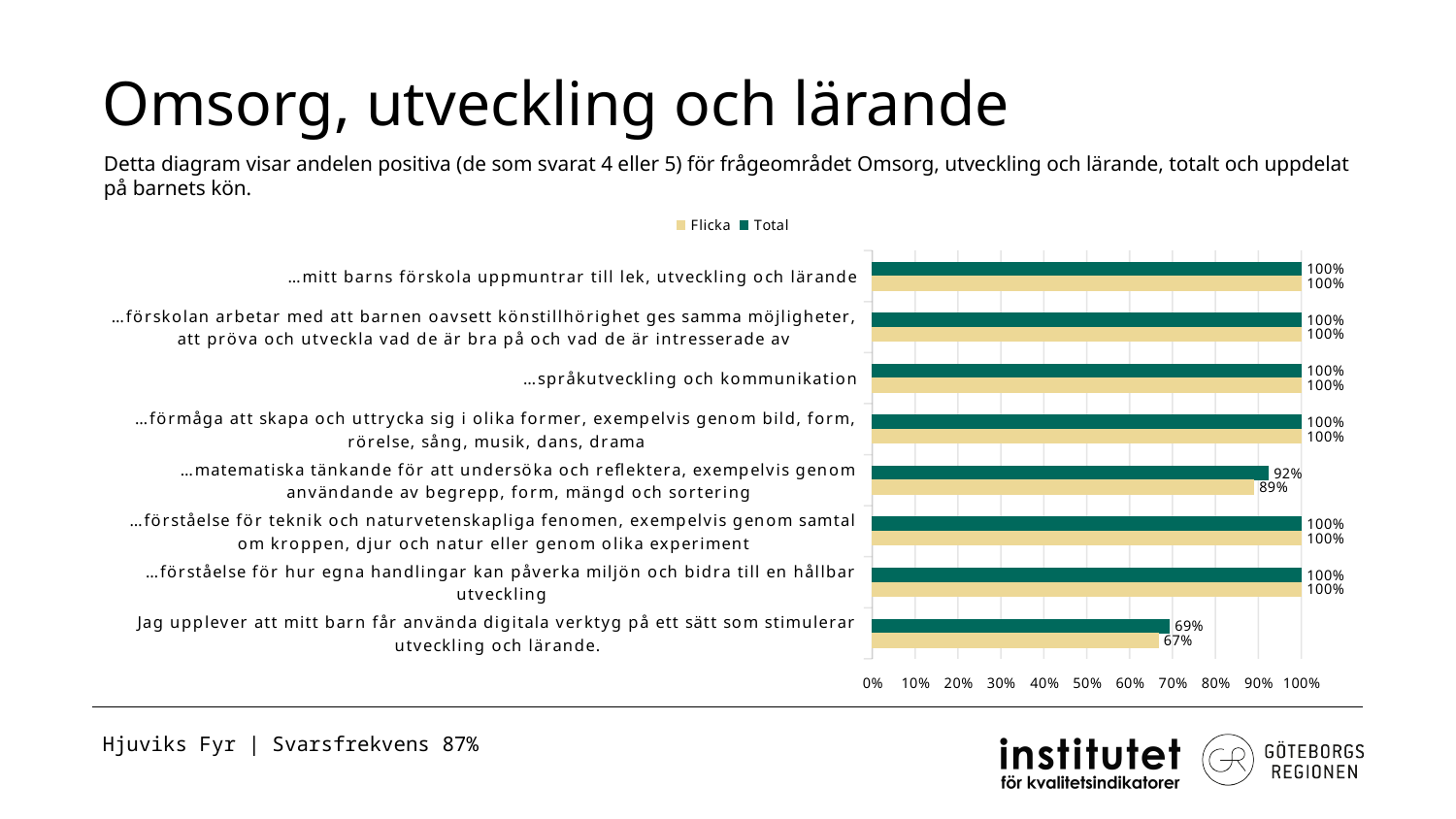
What type of chart is shown on the slide? bar chart What is the Flicka value for "…matematiska tänkande för att undersöka och reflektera, exempelvis genom användande av begrepp, form, mängd och sortering"? 89% What is the Total value for "…matematiska tänkande för att undersöka och reflektera, exempelvis genom användande av begrepp, form, mängd och sortering"? 92% How many categories (statements) are plotted in the chart? 8 For "Jag upplever att mitt barn får använda digitala verktyg på ett sätt som stimulerar utveckling och lärande.", which is larger, the Total value or the Flicka value? Total What is the difference between the Total and Flicka values for "…matematiska tänkande för att undersöka och reflektera, exempelvis genom användande av begrepp, form, mängd och sortering"? 3 percentage points What is the Flicka value for "…språkutveckling och kommunikation"? 100% What is the Flicka value for "Jag upplever att mitt barn får använda digitala verktyg på ett sätt som stimulerar utveckling och lärande."? 67% How many series does the legend list? 2 Which category has the lowest Total value? Jag upplever att mitt barn får använda digitala verktyg på ett sätt som stimulerar utveckling och lärande. Which series is shown in green in the chart? Total What is the Total value for "Jag upplever att mitt barn får använda digitala verktyg på ett sätt som stimulerar utveckling och lärande."? 69%